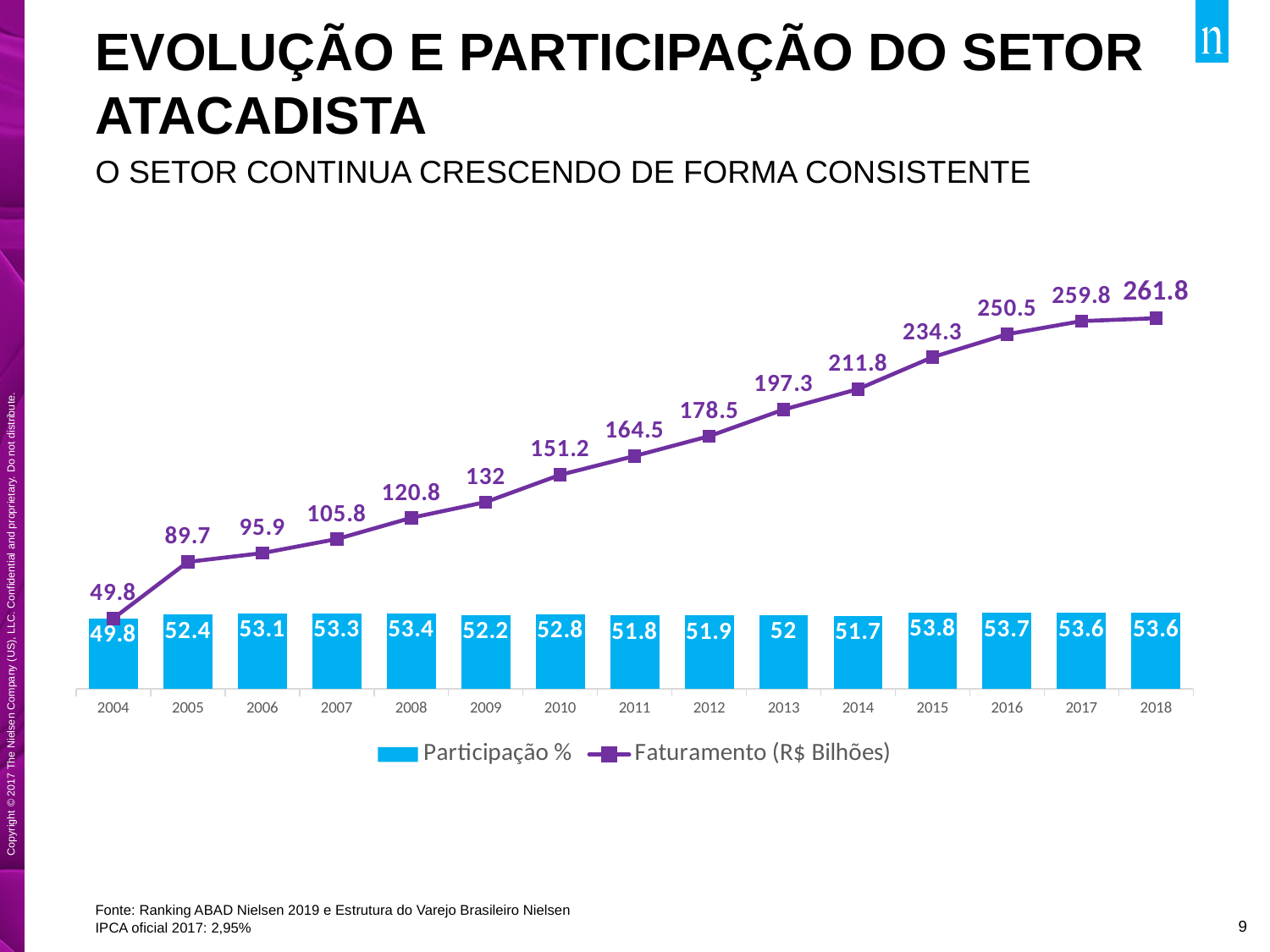
Which year has the lowest Faturamento (R$ Bilhões) value? 2004 What is the Participação % value for 2013? 52 What is the difference between the Faturamento (R$ Bilhões) values for 2018 and 2004? 212 Which year has the highest Participação % value? 2015 Which is larger, the Participação % value for 2008 or for 2014? 2008 How many series does the legend list? 2 Which series is shown as a line in the chart? Faturamento (R$ Bilhões) What is the Faturamento (R$ Bilhões) value for 2010? 151.2 What is the Participação % value for 2004? 49.8 What is the Faturamento (R$ Bilhões) value for 2018? 261.8 Does the Faturamento (R$ Bilhões) series rise or fall from 2004 to 2018? rise How many years are shown on the x axis? 15